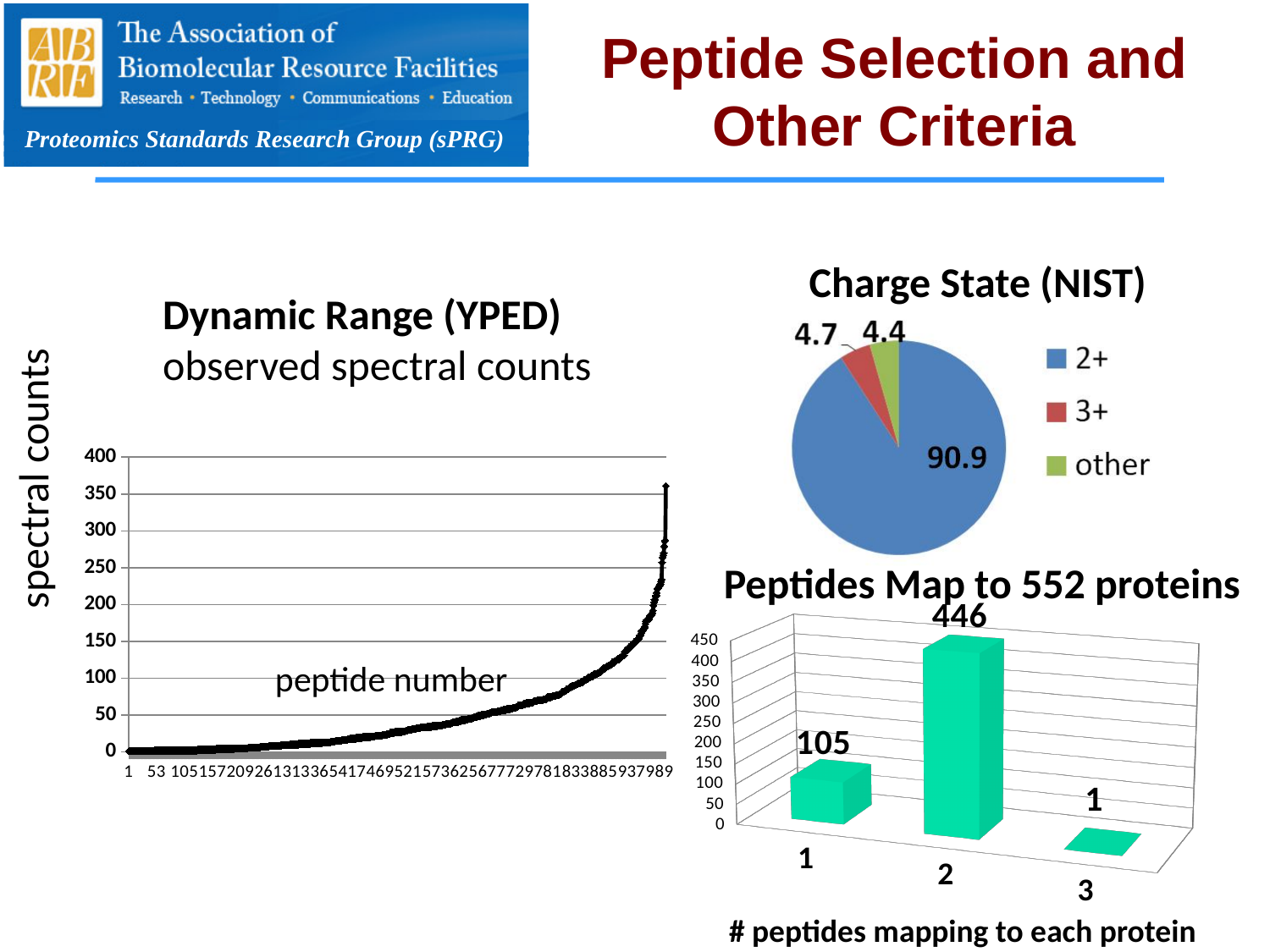
In the Charge State (NIST) pie chart, what is the difference between the 2+ value and the 3+ value? 86.2 In the 'Peptides Map to 552 proteins' chart, what is the value for category 2? 446 In the Charge State (NIST) pie chart, what percentage of the pie is the 2+ slice? 90.9 How many entries does the legend of the Charge State (NIST) pie chart list? 3 In the 'Peptides Map to 552 proteins' chart, what is the difference between the values for category 2 and category 1? 341 In the Charge State (NIST) pie chart, which charge state has the largest slice? 2+ In the 'Peptides Map to 552 proteins' chart, what is the value for category 1? 105 In the Charge State (NIST) pie chart, what value is shown for the 'other' slice? 4.4 In the 'Peptides Map to 552 proteins' chart, which category has the lowest value? 3 What kind of chart is the 'Peptides Map to 552 proteins' chart? bar chart In the Charge State (NIST) pie chart, what value is shown for the 3+ slice? 4.7 In the Dynamic Range (YPED) chart, do the spectral counts rise or fall as the peptide number increases along the x axis? rise